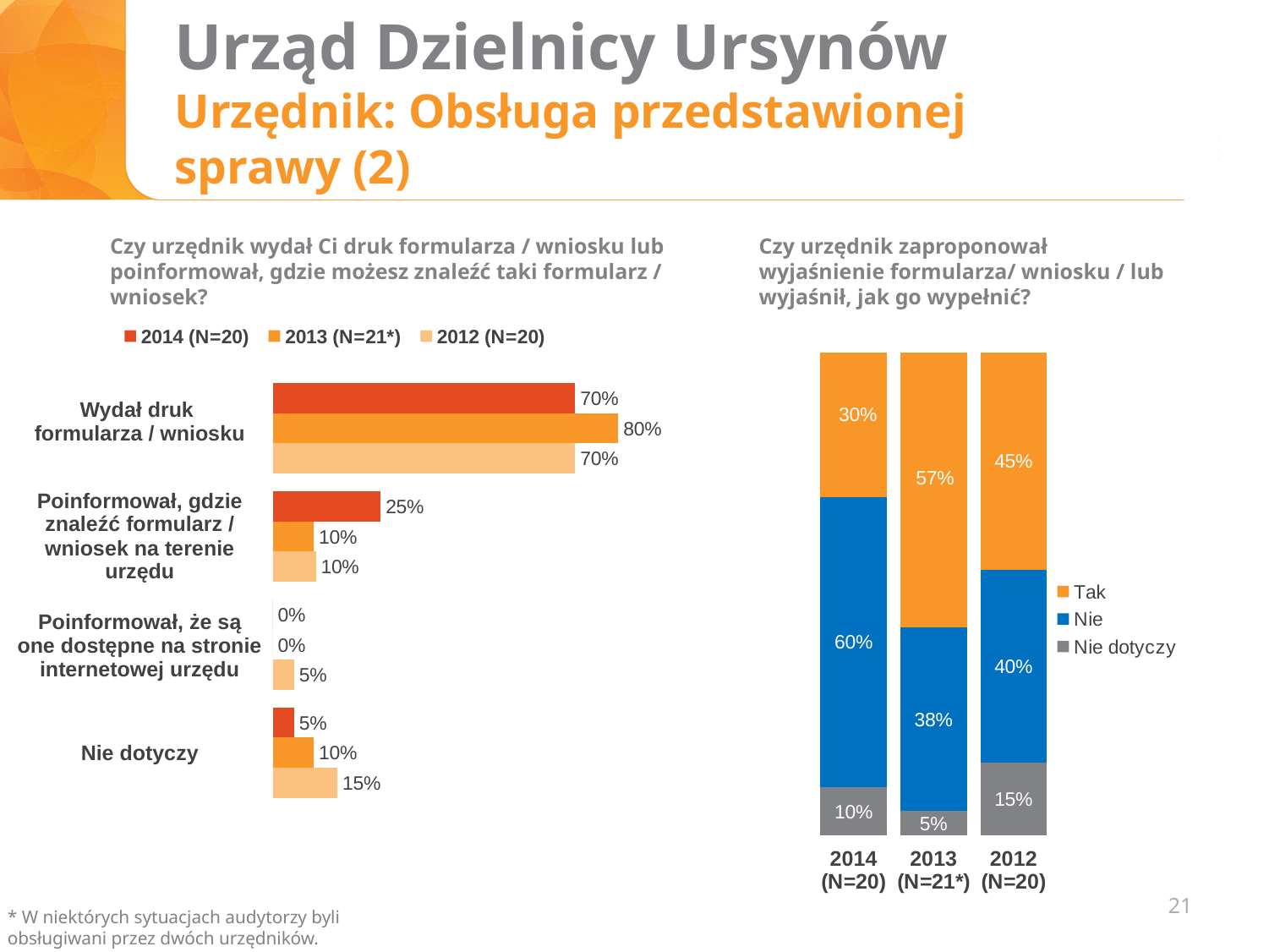
In the left chart, what is the difference between the 2013 and 2014 values for 'Wydał druk formularza / wniosku'? 10% In the left chart, what is the value for 'Nie dotyczy' in 2012 (N=20)? 15% In the left chart, what is the value for 'Wydał druk formularza / wniosku' in 2013 (N=21*)? 80% In the right chart, which year has the highest 'Nie dotyczy' share? 2012 (N=20) In the left chart, how many series does the legend list? 3 In the right chart, what is the 'Tak' share for 2013 (N=21*)? 57% What kind of chart is the chart on the right? Stacked bar chart In the left chart, how many categories are shown? 4 In the right chart, what is the 'Nie' share for 2014 (N=20)? 60% In the left chart, what is the value for 'Poinformował, gdzie znaleźć formularz / wniosek na terenie urzędu' in 2014 (N=20)? 25% In the left chart, which category has the highest value for 2014 (N=20)? Wydał druk formularza / wniosku In the right chart, is the 'Tak' share larger for 2012 (N=20) or for 2014 (N=20)? 2012 (N=20)